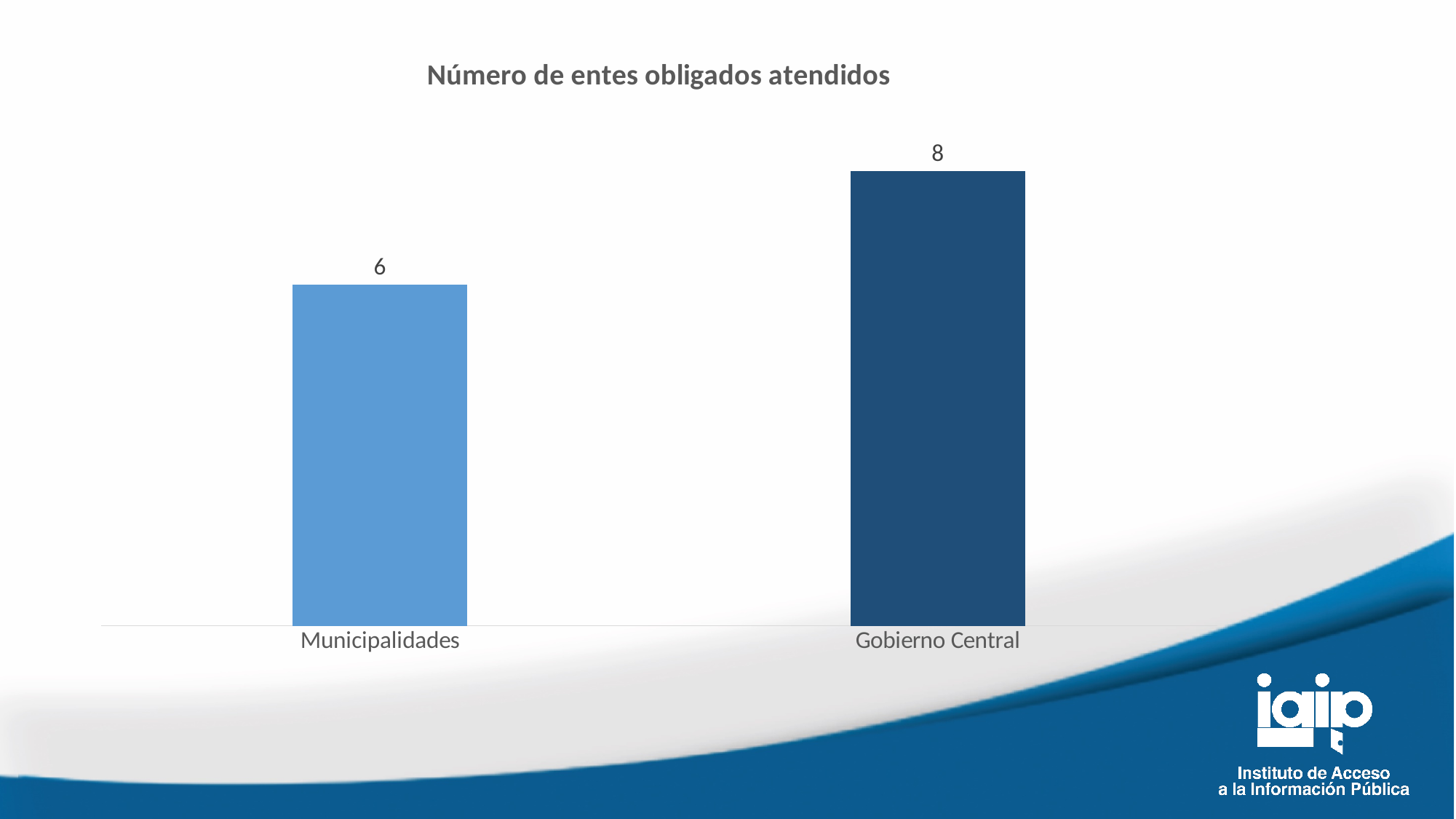
Which bar is drawn in the darker blue colour? Gobierno Central What is the total of the two values shown in the chart? 14 Which is larger, the value for Municipalidades or the value for Gobierno Central? Gobierno Central What is the title of the chart? Número de entes obligados atendidos Do the values rise or fall from Municipalidades to Gobierno Central? Rise Which category has the highest value? Gobierno Central Which category has the lowest value? Municipalidades What is the value for Municipalidades? 6 What is the difference between the values for Gobierno Central and Municipalidades? 2 How many categories are shown in the chart? 2 What is the value for Gobierno Central? 8 What kind of chart is shown on the slide? Bar chart